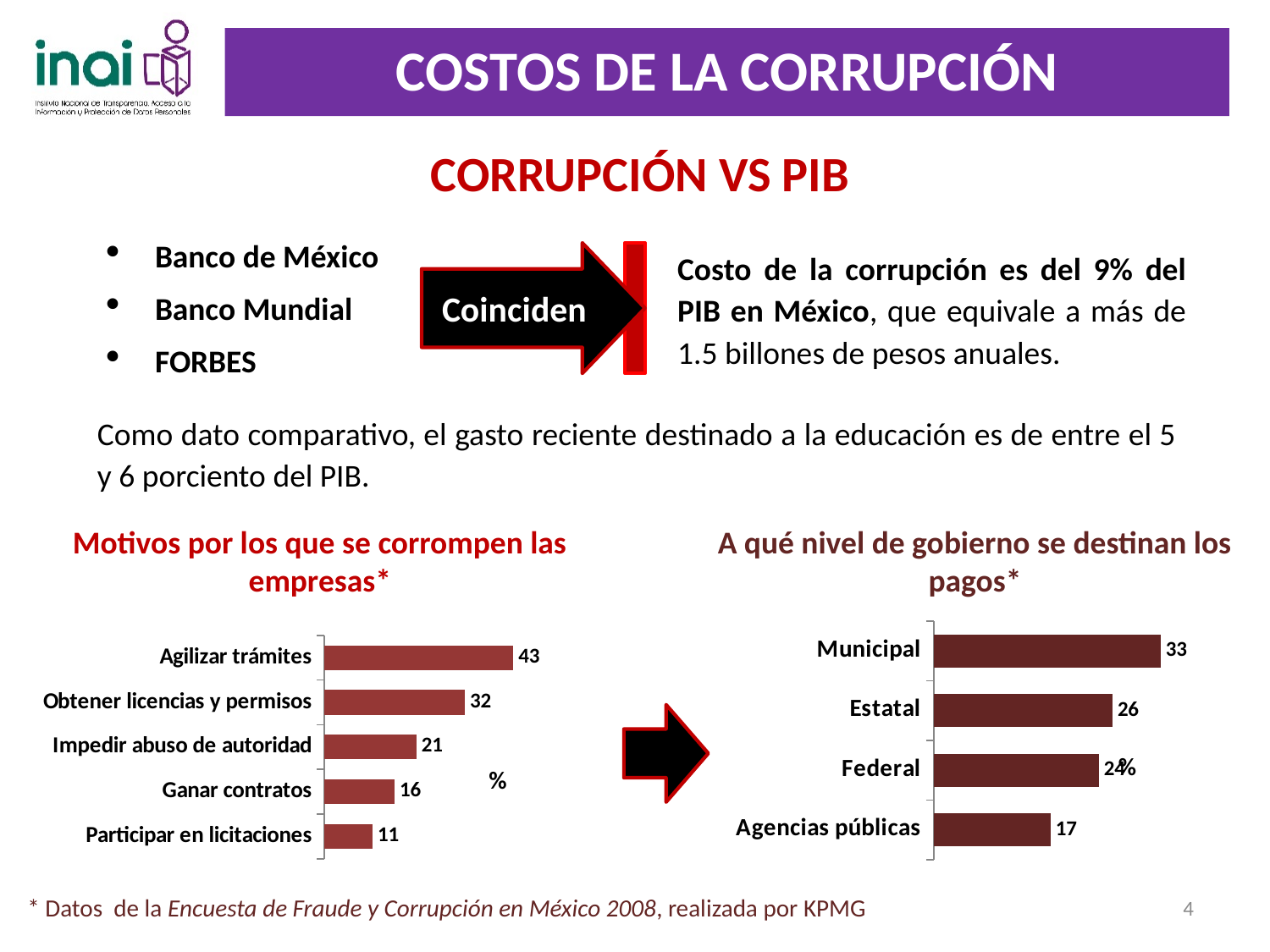
In the chart 'Motivos por los que se corrompen las empresas', what is the value for Ganar contratos? 16 In the chart 'A qué nivel de gobierno se destinan los pagos', what is the difference between Municipal and Estatal? 7 In the chart 'A qué nivel de gobierno se destinan los pagos', what is the value for Agencias públicas? 17 In the chart 'Motivos por los que se corrompen las empresas', which is larger: Impedir abuso de autoridad or Ganar contratos? Impedir abuso de autoridad What type of chart is 'A qué nivel de gobierno se destinan los pagos'? Bar chart In the chart 'Motivos por los que se corrompen las empresas', which category has the lowest value? Participar en licitaciones In the chart 'A qué nivel de gobierno se destinan los pagos', how many categories are shown? 4 In the chart 'Motivos por los que se corrompen las empresas', what is the value for Agilizar trámites? 43 In the chart 'A qué nivel de gobierno se destinan los pagos', which level has the highest value? Municipal In the chart 'A qué nivel de gobierno se destinan los pagos', what is the value for Municipal? 33 In the chart 'Motivos por los que se corrompen las empresas', what is the difference between Agilizar trámites and Obtener licencias y permisos? 11 In the chart 'Motivos por los que se corrompen las empresas', how many categories are shown? 5